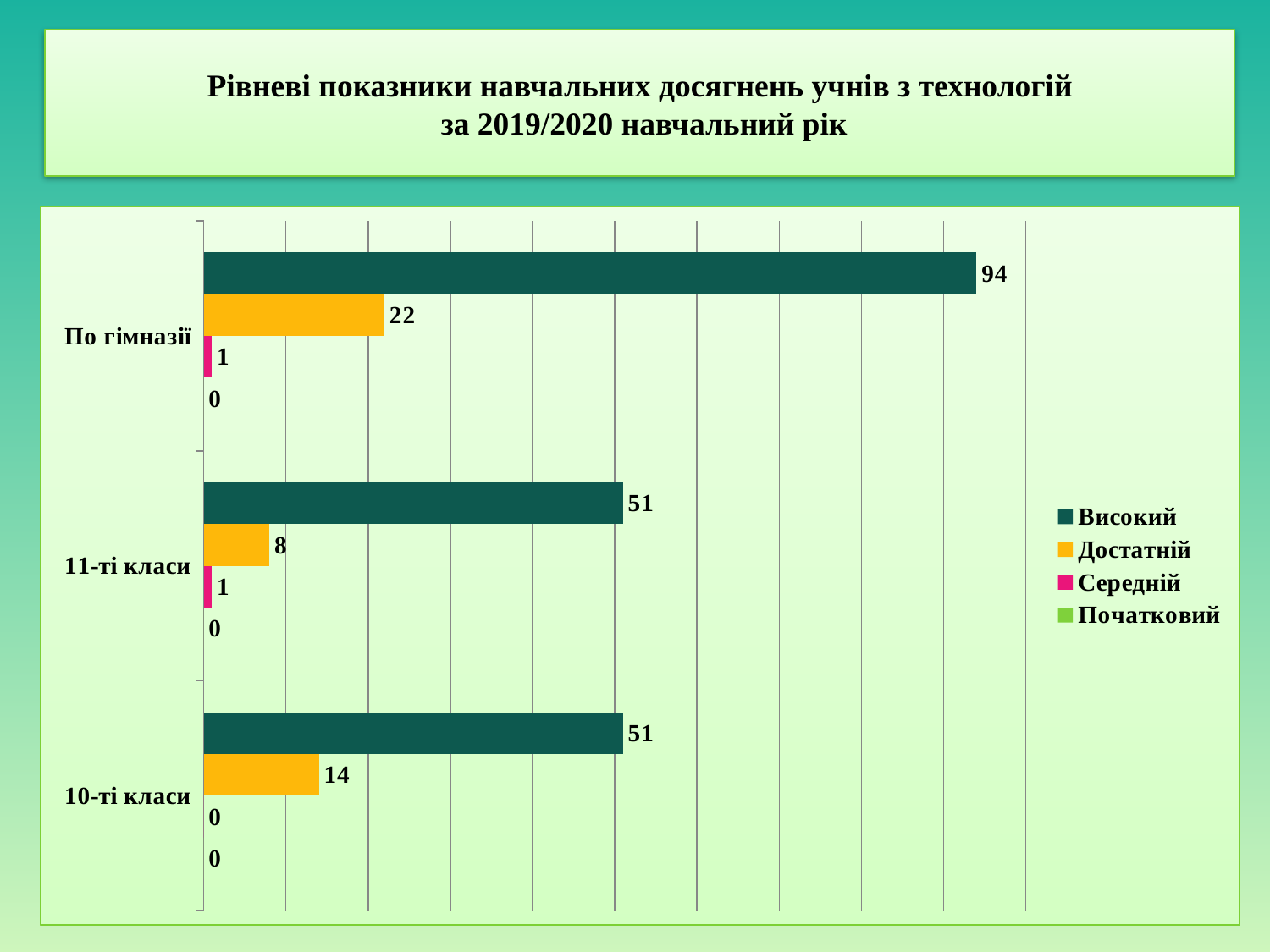
What is the difference between the Достатній values for 10-ті класи and 11-ті класи? 6 What is the value for Середній for 11-ті класи? 1 Which category has the highest value for Високий? По гімназії Which is larger: the Високий value for По гімназії or the Високий value for 11-ті класи? По гімназії How many series does the legend list? 4 Which category has the lowest value for Достатній? 11-ті класи How many categories are shown on the chart? 3 What is the value for Високий for По гімназії? 94 What is the value for Початковий for По гімназії? 0 What kind of chart is shown on the slide? bar chart What is the value for Достатній for 10-ті класи? 14 What is the value for Достатній for 11-ті класи? 8